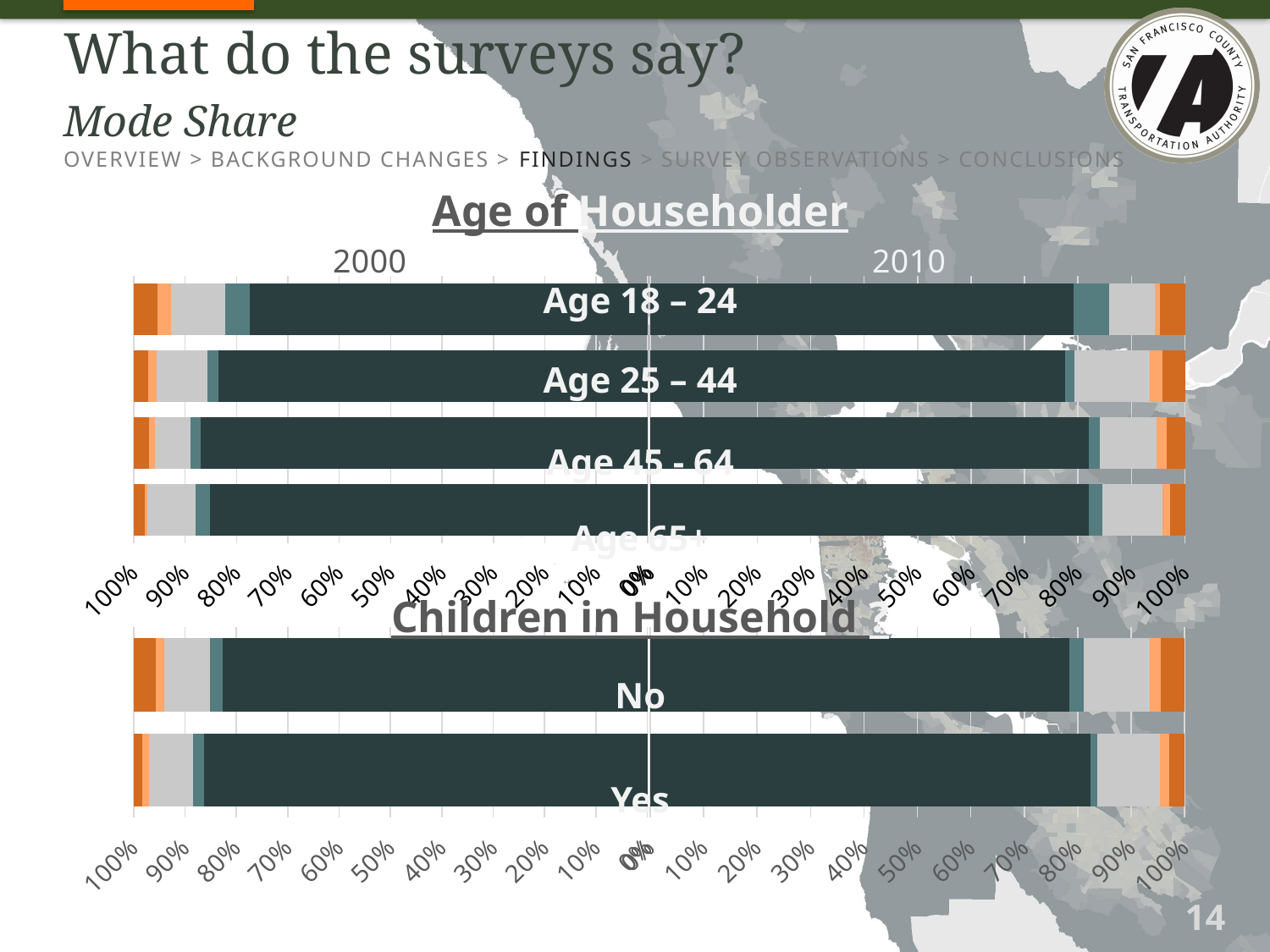
In the "Age of Householder" chart, is the dark green segment for Age 65+ in 2010 greater or less than 70%? greater In the "Age of Householder" chart, is the dark green segment for Age 18 – 24 in 2000 greater or less than 70%? greater In the "Children in Household" chart, is the dark green segment for No in 2010 greater or less than 90%? less How many categories are shown in the "Children in Household" chart? 2 How many age categories are shown in the "Age of Householder" chart? 4 What kind of chart is the "Children in Household" chart? bar chart Which two survey years are compared in the "Age of Householder" chart? 2000 and 2010 What kind of chart is the "Age of Householder" chart? bar chart What is the highest percentage tick shown on the x axis of the "Age of Householder" chart? 100% What is the title of the lower chart on the slide? Children in Household